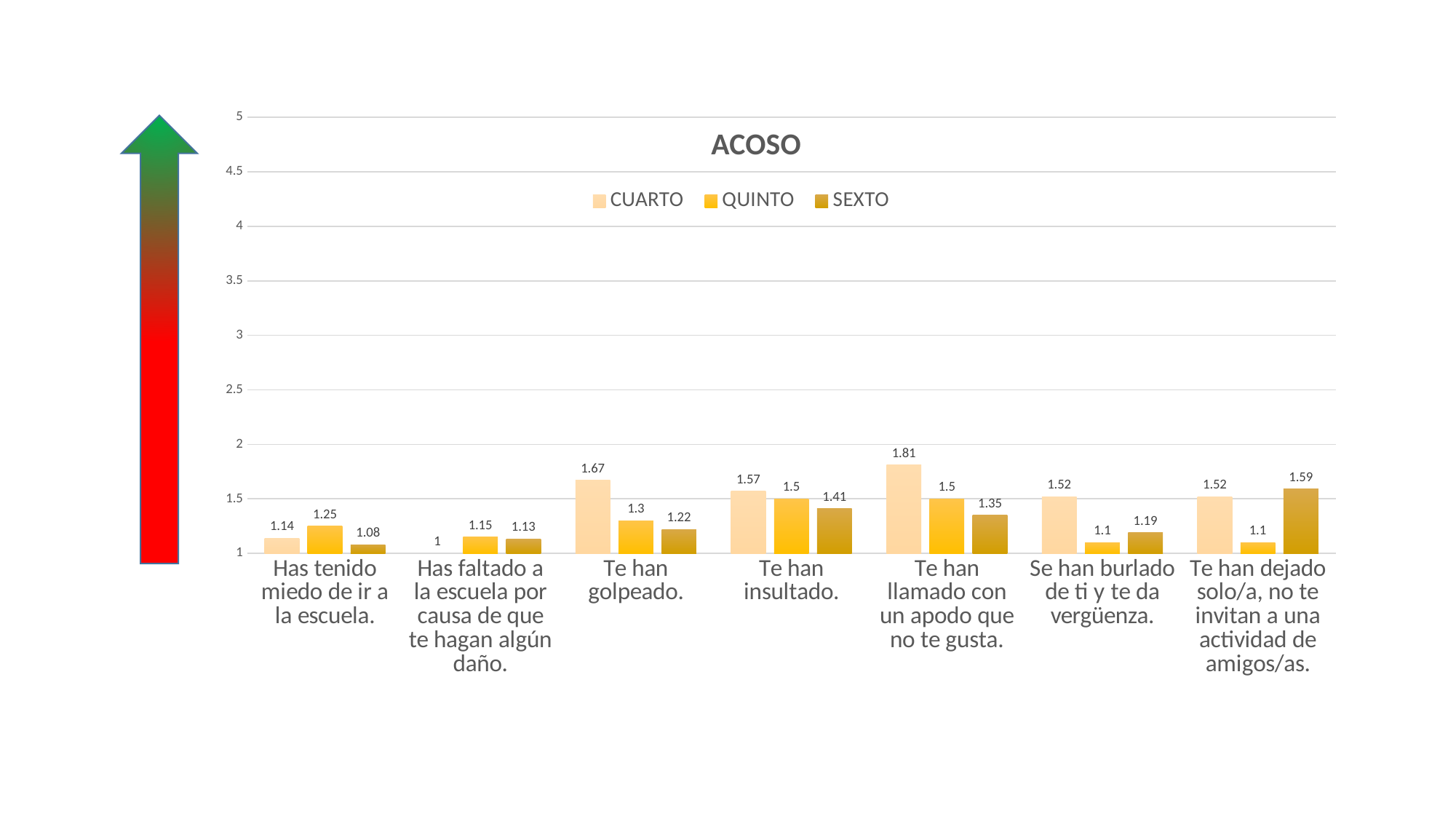
For "Se han burlado de ti y te da vergüenza.", which is larger, the QUINTO value or the SEXTO value? SEXTO Which category has the lowest SEXTO value? Has tenido miedo de ir a la escuela. What kind of chart is shown on the slide? bar chart How many series does the legend list? 3 Is the CUARTO value for "Te han insultado." greater or less than 2? less How many categories are shown on the x axis? 7 What is the title of the chart? ACOSO What is the QUINTO value for "Has tenido miedo de ir a la escuela."? 1.25 What is the CUARTO value for "Te han golpeado."? 1.67 What is the SEXTO value for "Te han dejado solo/a, no te invitan a una actividad de amigos/as."? 1.59 What is the difference between the CUARTO and SEXTO values for "Te han llamado con un apodo que no te gusta."? 0.46 Which category has the highest CUARTO value? Te han llamado con un apodo que no te gusta.